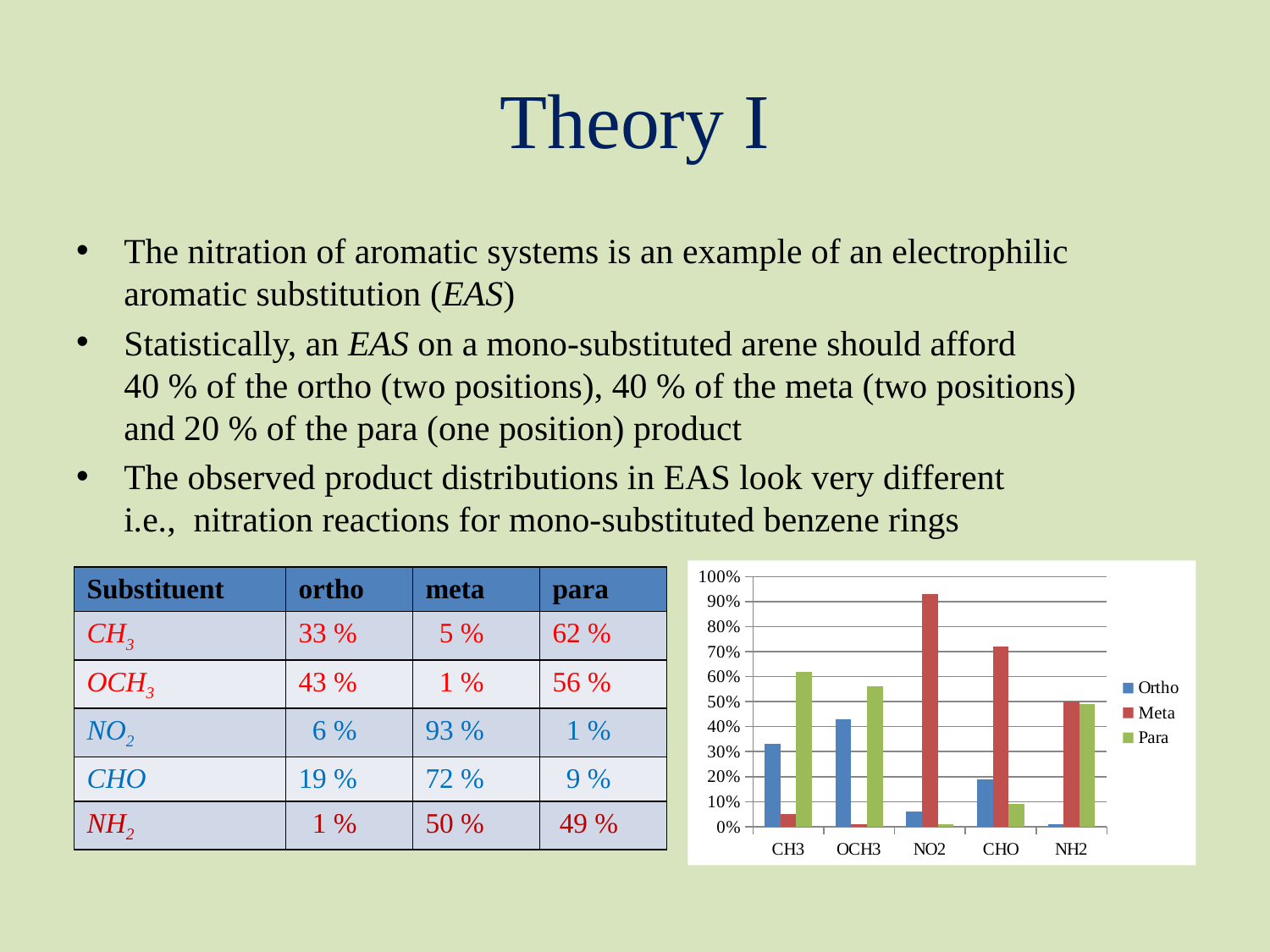
Which substituent has the tallest Para bar in the chart? CH3 Which substituent has the tallest Ortho bar in the chart? OCH3 What is the Meta value for NO2 in the chart? 93 % How many series does the chart legend list? 3 What colour represents the Para series in the chart? green How many substituent categories are shown on the x axis of the chart? 5 Is the Ortho bar for CH3 taller or shorter than the Ortho bar for OCH3? shorter Is the Meta value for NO2 greater or less than 80%? greater Which substituent has the tallest Meta bar in the chart? NO2 Is the Para value for CH3 greater or less than 50%? greater Is the Ortho value for OCH3 greater or less than 50%? less What kind of chart is shown on the slide? bar chart